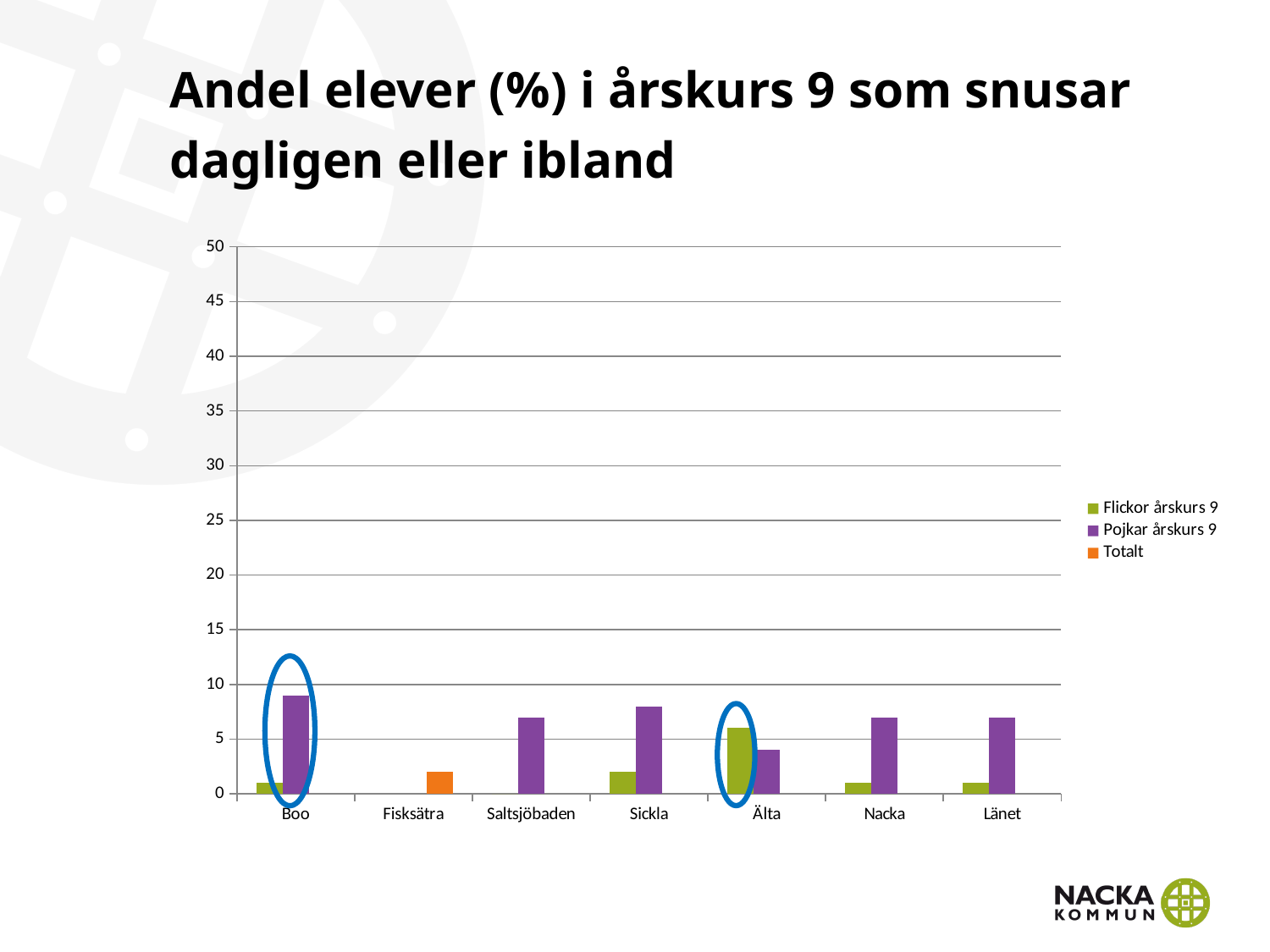
Is the value for Totalt in Fisksätra greater or less than 5? less What kind of chart is shown on the slide? bar chart In Boo, which is larger: Flickor årskurs 9 or Pojkar årskurs 9? Pojkar årskurs 9 How many categories are shown along the x axis? 7 Is the value for Pojkar årskurs 9 in Sickla greater or less than 5? greater Is the value for Pojkar årskurs 9 in Saltsjöbaden greater or less than 10? less Which category is the only one with a Totalt (orange) bar? Fisksätra In Älta, which is larger: Flickor årskurs 9 or Pojkar årskurs 9? Flickor årskurs 9 Which is larger: Pojkar årskurs 9 in Boo or Pojkar årskurs 9 in Älta? Boo How many series does the legend list? 3